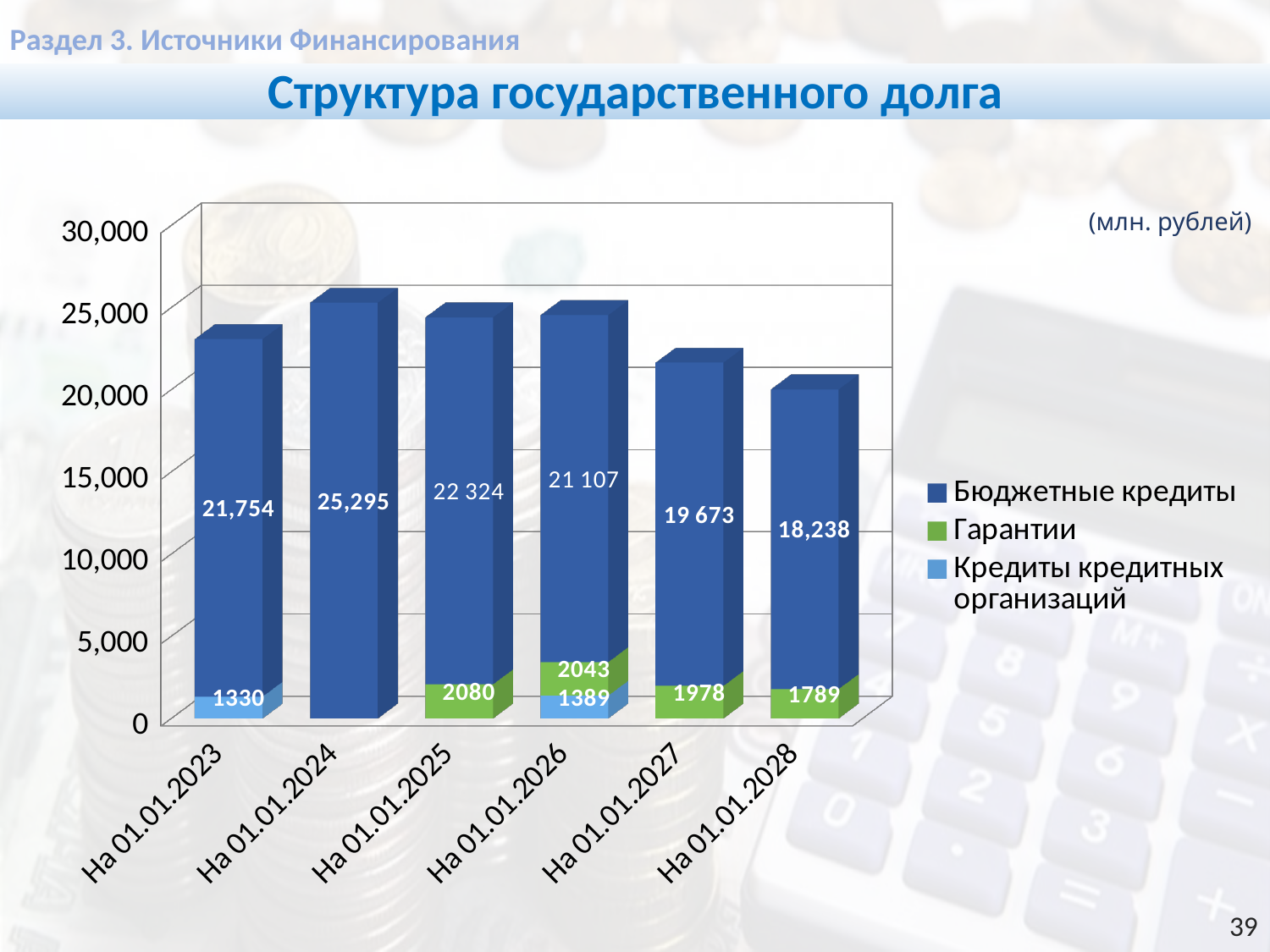
What is the difference between Бюджетные кредиты for На 01.01.2024 and На 01.01.2028? 7,057 Which date has the highest value of Бюджетные кредиты? На 01.01.2024 Which is larger: Кредиты кредитных организаций for На 01.01.2023 or for На 01.01.2026? На 01.01.2026 Which date has the lowest value of Бюджетные кредиты? На 01.01.2028 What is the value of Гарантии for На 01.01.2025? 2080 Is the total height of the bar for На 01.01.2028 greater or less than 25,000? less How many series does the legend list? 3 What is the value of Кредиты кредитных организаций for На 01.01.2026? 1389 What kind of chart is shown on the slide? Stacked bar chart How many dates are shown on the x axis? 6 What is the value of Бюджетные кредиты for На 01.01.2024? 25,295 What is the total of the stacked bar for На 01.01.2027? 21 651